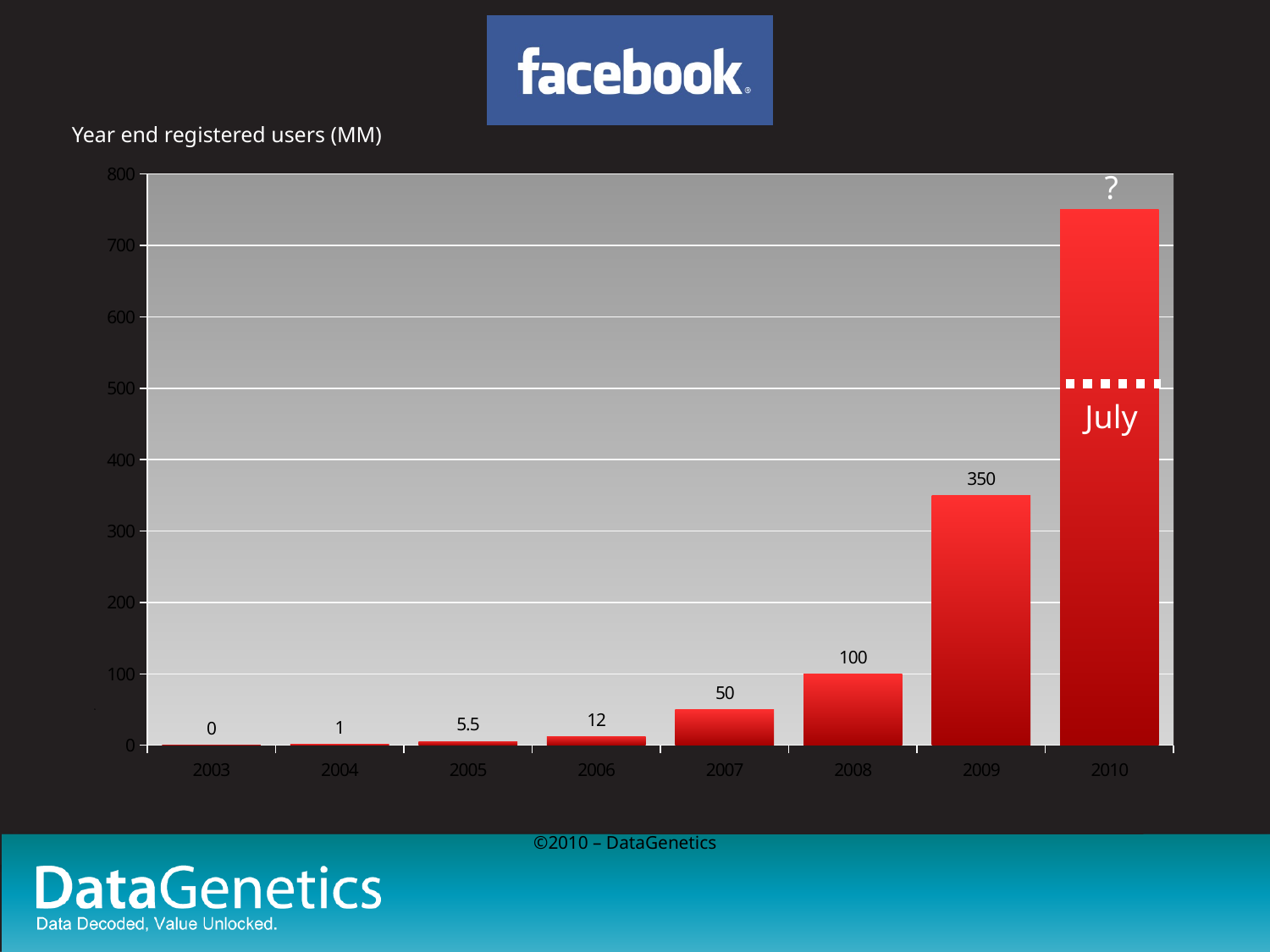
Is the value for 2010 greater or less than 700? greater What is the value for 2006? 12 What is the value for 2005? 5.5 What is the value for 2007? 50 Which year has the lowest value? 2003 What is the difference between the values for 2009 and 2008? 250 How many years are shown on the x axis? 8 Which is larger, the value for 2008 or the value for 2007? 2008 What kind of chart is this? Bar chart Which year has the tallest bar? 2010 What is the value for 2009? 350 What data label is shown above the 2010 bar? ?